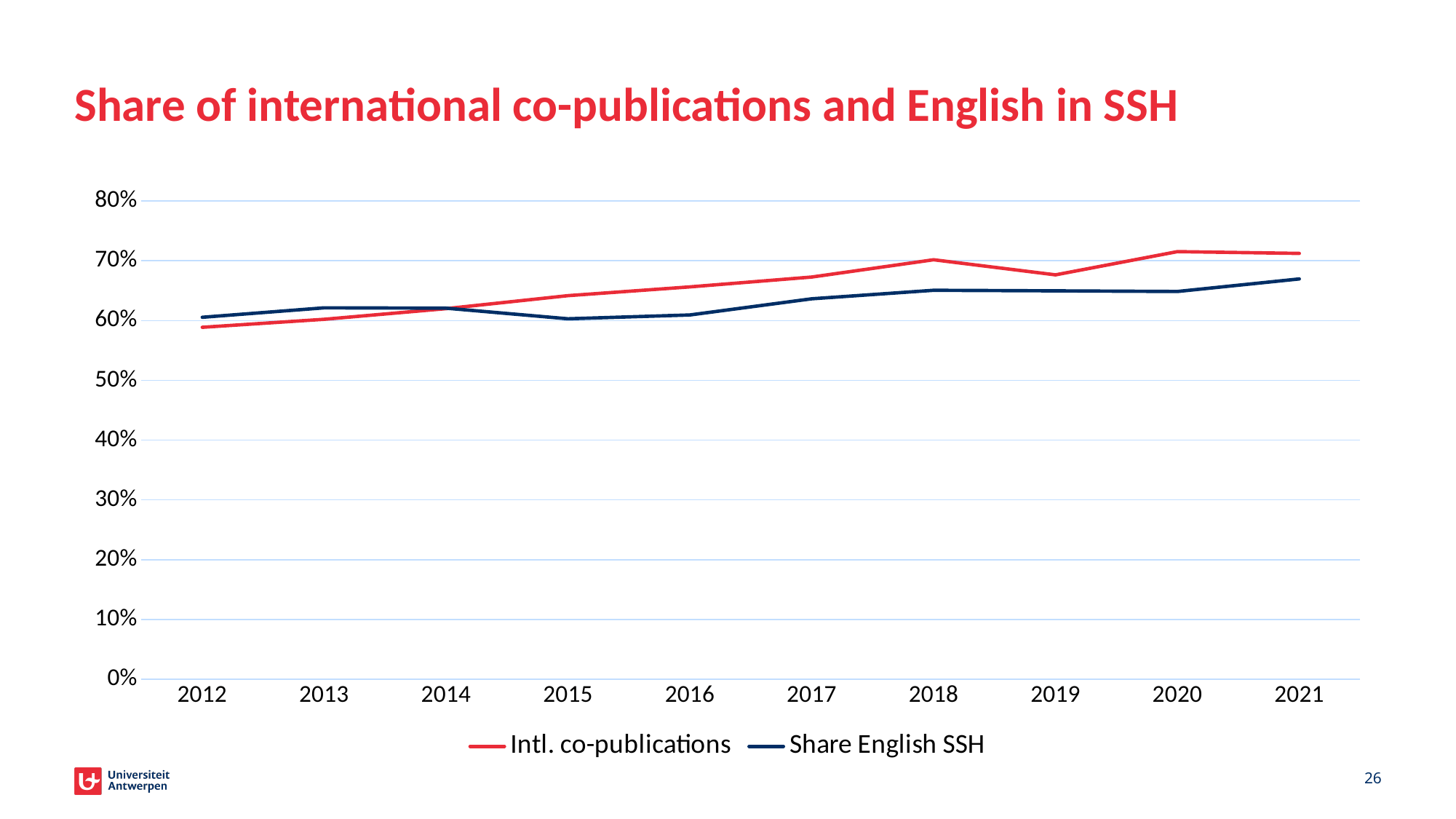
Which series is drawn in red? Intl. co-publications Is the value for Intl. co-publications in 2020 greater or less than 70%? greater What kind of chart is shown on the slide? line chart What is the title of the chart? Share of international co-publications and English in SSH How many series does the legend list? 2 In 2012, which series has the higher value, Intl. co-publications or Share English SSH? Share English SSH Is the value for Intl. co-publications in 2018 greater or less than 60%? greater How many years are plotted along the x axis? 10 Is the value for Intl. co-publications in 2012 greater or less than 60%? less In 2019, which series has the higher value, Intl. co-publications or Share English SSH? Intl. co-publications Overall, does the Intl. co-publications line rise or fall from 2012 to 2021? rise